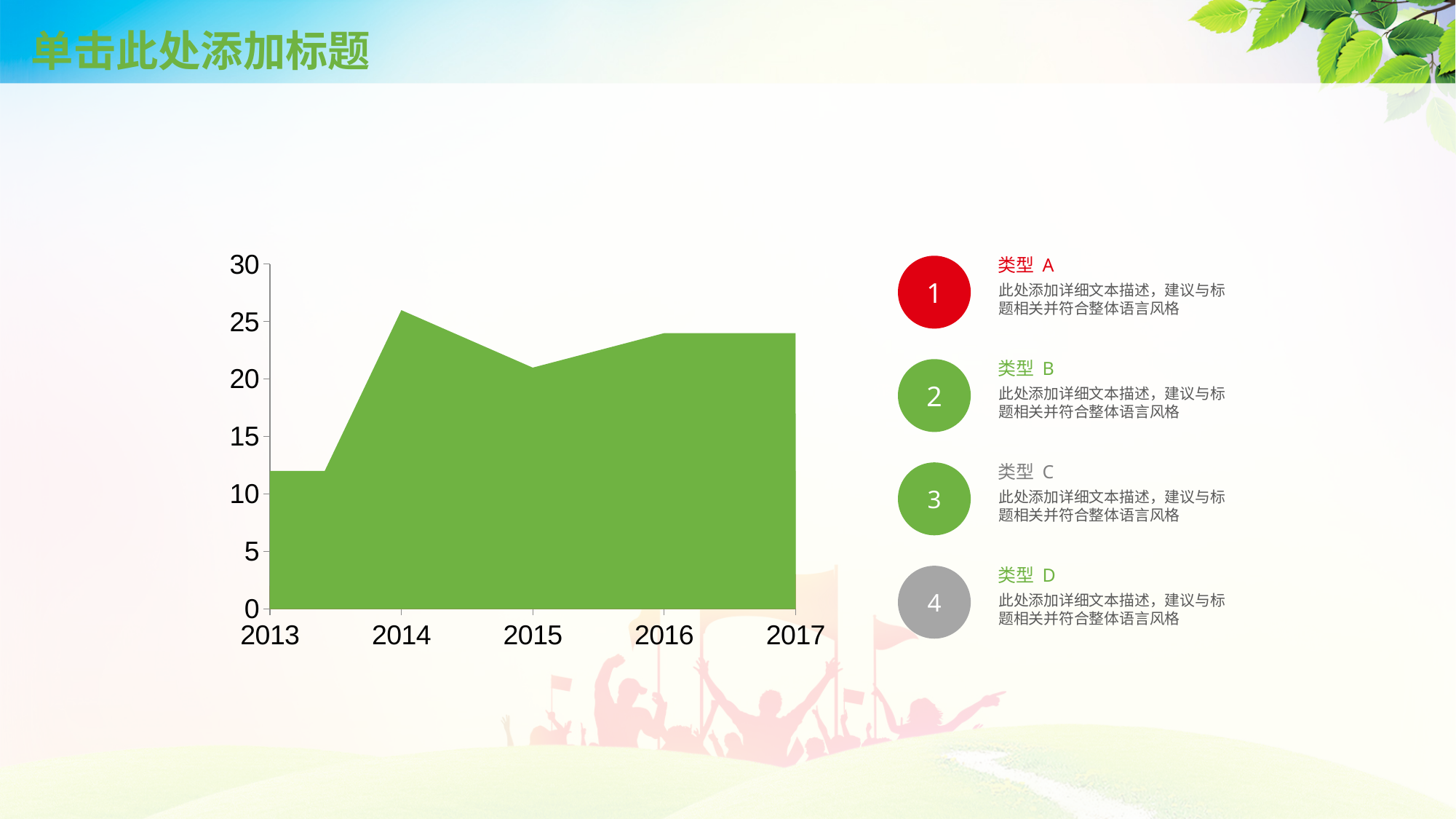
Is the value for 2017 greater or less than 20? greater Is the value for 2016 greater or less than 25? less Is the value for 2014 greater or less than 25? greater Which is larger, the value for 2013 or the value for 2016? 2016 What kind of chart is shown on the slide? area chart Which year has the lowest value in the chart? 2013 Does the value rise or fall from 2014 to 2015? fall How many years are shown on the x axis of the chart? 5 Which is larger, the value for 2014 or the value for 2015? 2014 Which year has the highest value in the chart? 2014